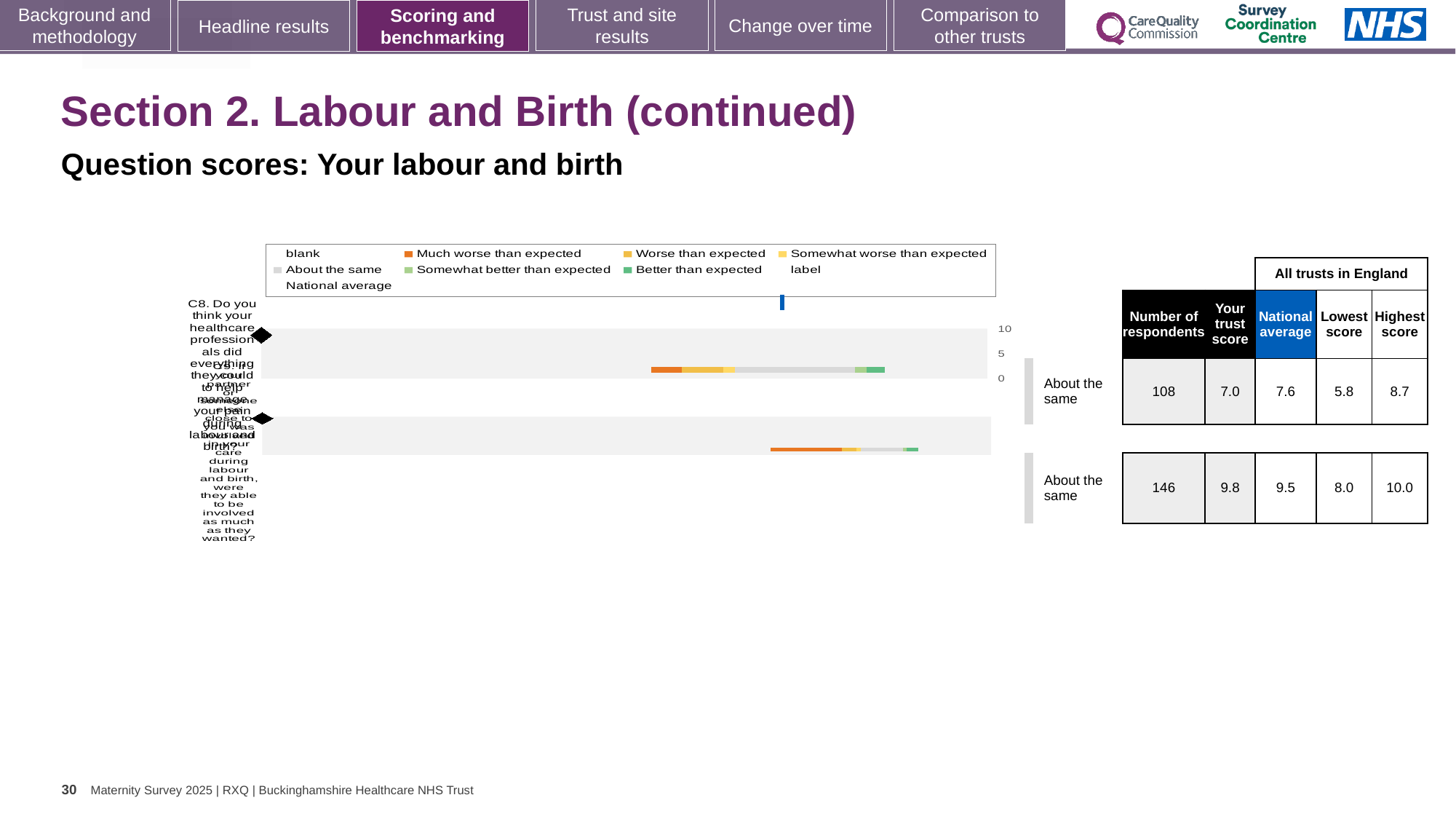
In the table next to the chart, what is the national average for question C8? 7.6 In the table next to the chart, what is the number of respondents for question C8? 108 What is the highest value shown on the chart's axis? 10 In the table, which is larger for question C8: the trust score or the national average? national average Which legend entry is shown in orange? Much worse than expected In the table next to the chart, what is the number of respondents for the second question (partner involvement)? 146 In the table, what is the difference between the trust score and the national average for the second question (partner involvement)? 0.3 How many survey questions (bars) are plotted in the chart? 2 What kind of chart is shown on the slide? bar chart In the table next to the chart, what is the trust score for question C8? 7.0 In the table next to the chart, what is the highest score for the second question (partner involvement)? 10.0 In the table, what is the difference between the highest score and the lowest score for question C8? 2.9